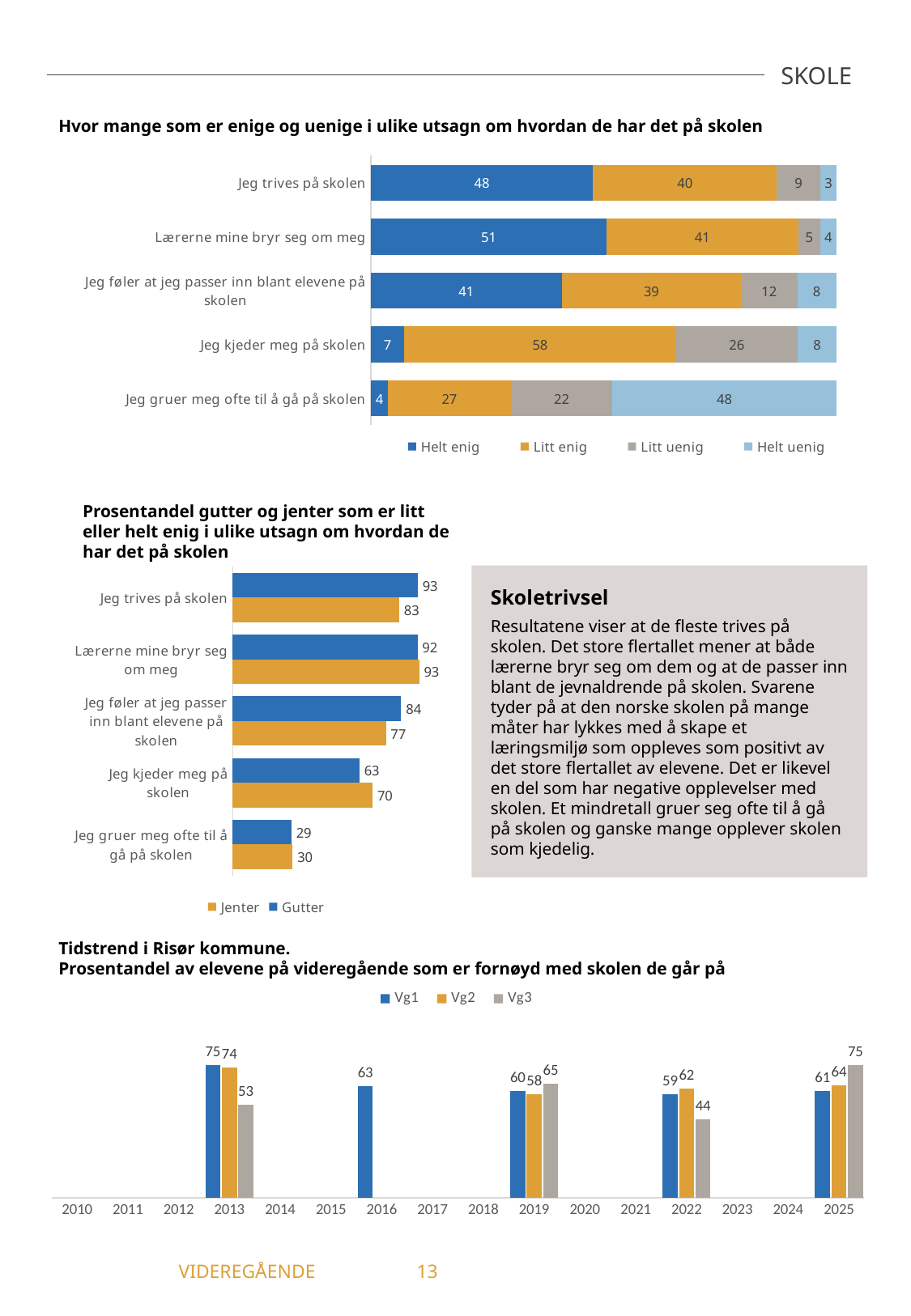
What kind of chart is the bottom chart 'Tidstrend i Risør kommune'? Bar chart In the top chart 'Hvor mange som er enige og uenige i ulike utsagn om hvordan de har det på skolen', what is the 'Helt enig' value for 'Lærerne mine bryr seg om meg'? 51 In the middle chart 'Prosentandel gutter og jenter som er litt eller helt enig i ulike utsagn om hvordan de har det på skolen', which statement has the lowest Gutter value? Jeg gruer meg ofte til å gå på skolen In the top chart 'Hvor mange som er enige og uenige i ulike utsagn om hvordan de har det på skolen', what is the 'Helt uenig' value for 'Jeg gruer meg ofte til å gå på skolen'? 48 In the middle chart 'Prosentandel gutter og jenter som er litt eller helt enig i ulike utsagn om hvordan de har det på skolen', what is the difference between the Gutter and Jenter values for 'Jeg trives på skolen'? 10 In the top chart 'Hvor mange som er enige og uenige i ulike utsagn om hvordan de har det på skolen', what is the total of the stacked bar for 'Jeg kjeder meg på skolen'? 99 In the top chart 'Hvor mange som er enige og uenige i ulike utsagn om hvordan de har det på skolen', how many series does the legend list? 4 In the bottom chart 'Tidstrend i Risør kommune', which year has the highest Vg3 value? 2025 In the middle chart 'Prosentandel gutter og jenter som er litt eller helt enig i ulike utsagn om hvordan de har det på skolen', what is the Gutter value for 'Jeg trives på skolen'? 93 In the bottom chart 'Tidstrend i Risør kommune', is the Vg1 value higher in 2013 or in 2025? 2013 In the bottom chart 'Tidstrend i Risør kommune', what is the Vg3 value for 2022? 44 In the middle chart 'Prosentandel gutter og jenter som er litt eller helt enig i ulike utsagn om hvordan de har det på skolen', what is the Jenter value for 'Jeg kjeder meg på skolen'? 70